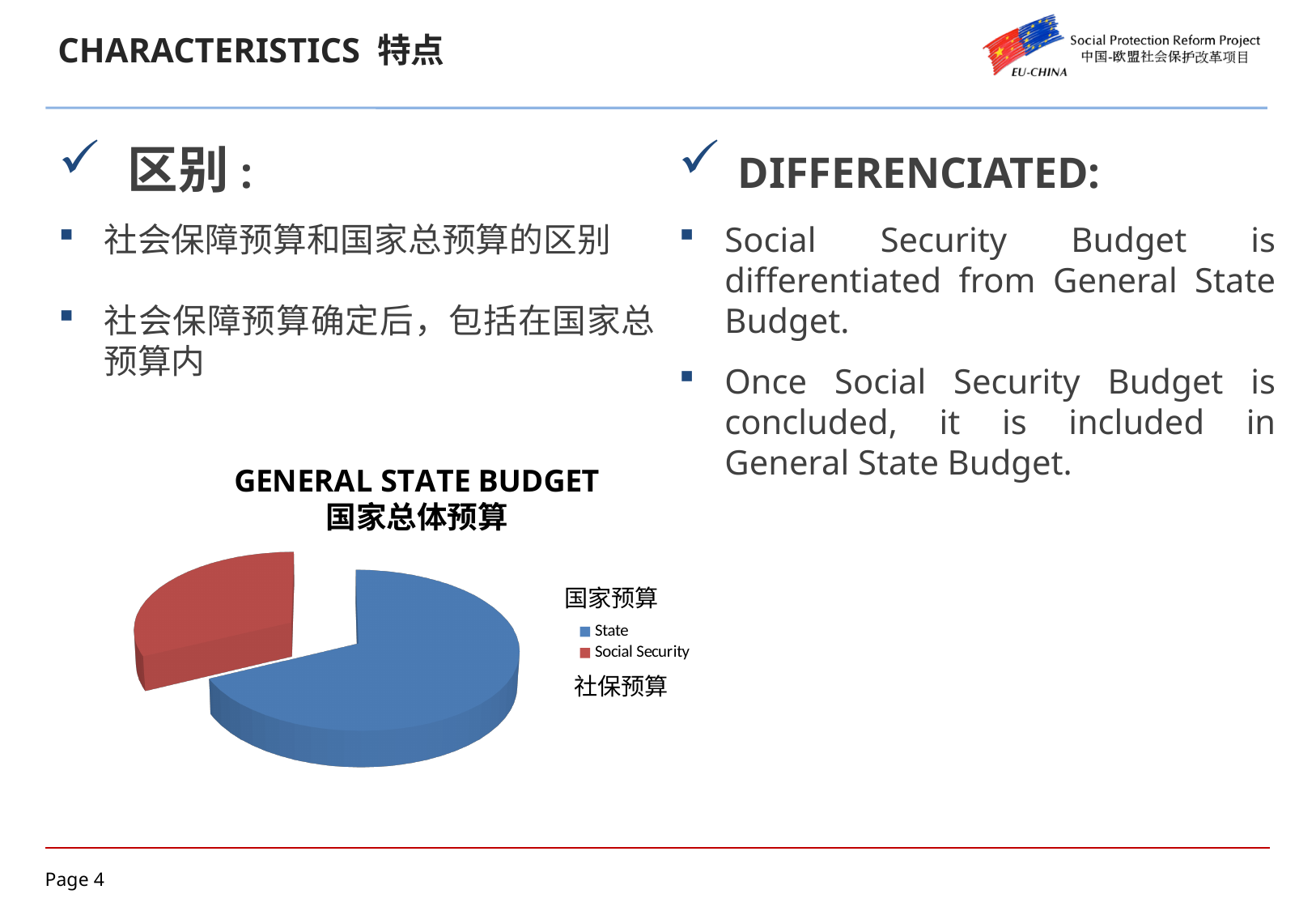
How many slices does the pie chart have? 2 Which slice of the pie chart is the largest? State How many entries does the legend of the pie chart list? 2 What colour is the Social Security slice in the pie chart? red In the pie chart, which is larger: the State slice or the Social Security slice? State What kind of chart is shown on the slide? pie chart Which slice of the pie chart is the smallest? Social Security What is the title of the pie chart? GENERAL STATE BUDGET 国家总体预算